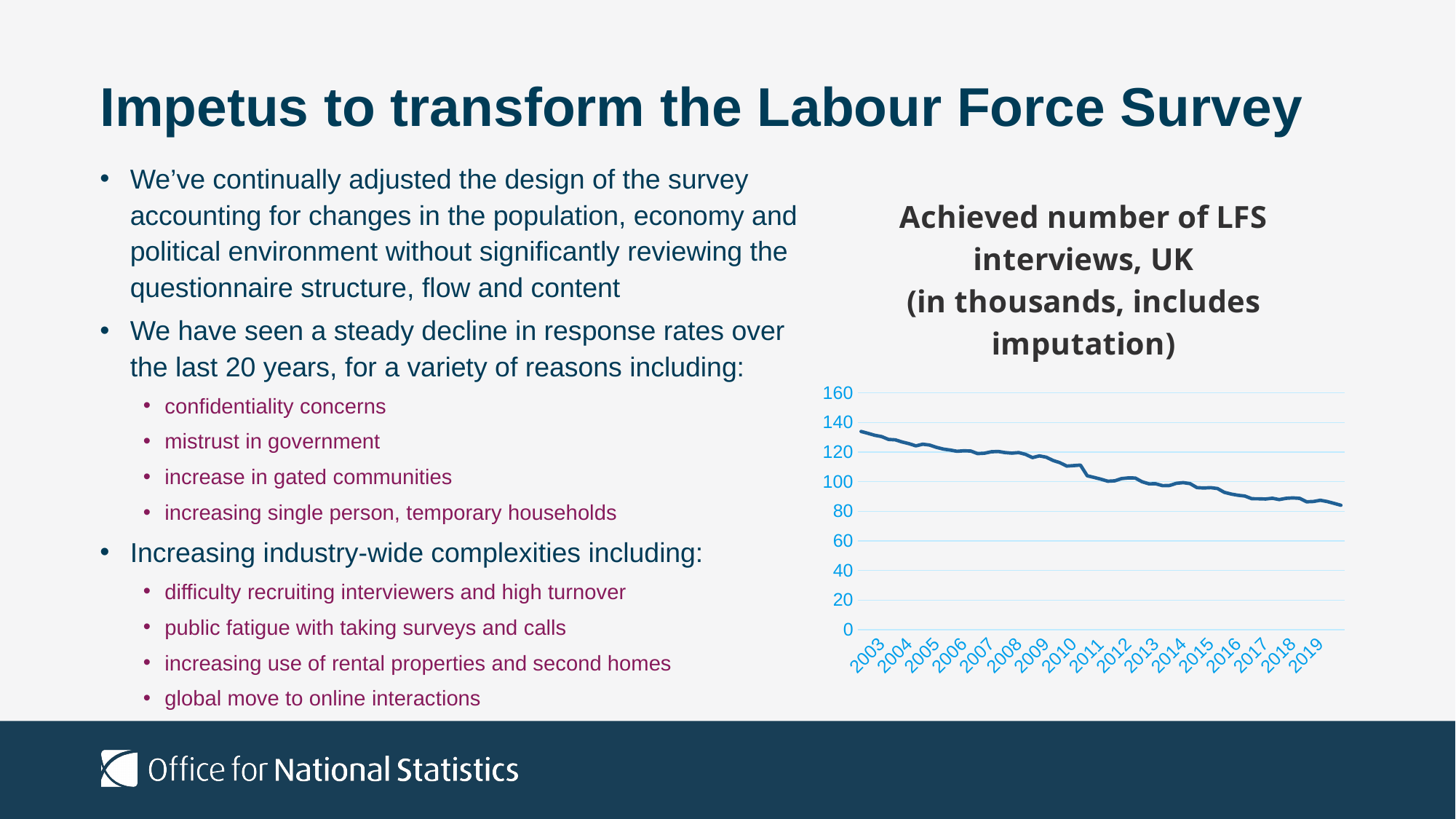
Is the value for 2003 greater or less than 120? greater How many years are labelled on the x axis of the chart? 17 Which year has the lowest value in the chart? 2019 What is the title of the chart? Achieved number of LFS interviews, UK (in thousands, includes imputation) Is the value for 2007 greater or less than 100? greater Is the value for 2019 greater or less than 100? less What is the highest tick value shown on the y axis? 160 Which is larger, the value for 2005 or the value for 2017? 2005 Which year has the highest value in the chart? 2003 Do the values in the chart rise or fall from 2003 to 2019? fall What kind of chart is shown on the slide? line chart